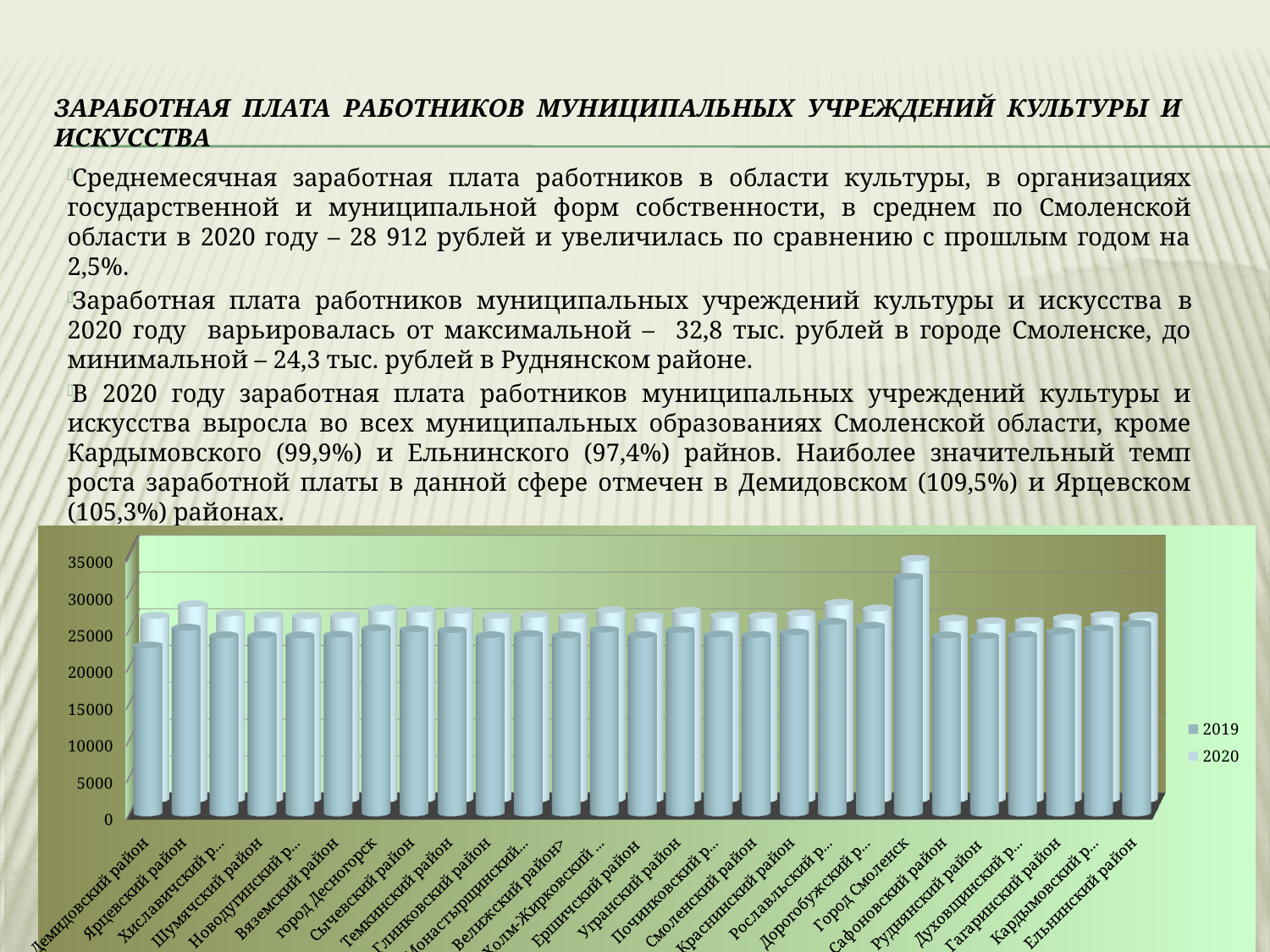
Is the 2019 value for Ярцевский район greater or less than 20000? greater Is the 2019 value for Демидовский район greater or less than 25000? less Which years are listed in the chart legend? 2019 and 2020 Which category has the highest value in the 2020 series? город Смоленск Which category has the highest value in the 2019 series? город Смоленск Which is larger: the 2020 value for город Смоленск or the 2020 value for Ярцевский район? город Смоленск Is the 2020 value for город Смоленск greater or less than 30000? greater What kind of chart is shown on the slide? bar chart How many districts (categories) are plotted on the x axis of the chart? 27 How many series does the chart legend list? 2 What is the highest tick value shown on the vertical axis of the chart? 35000